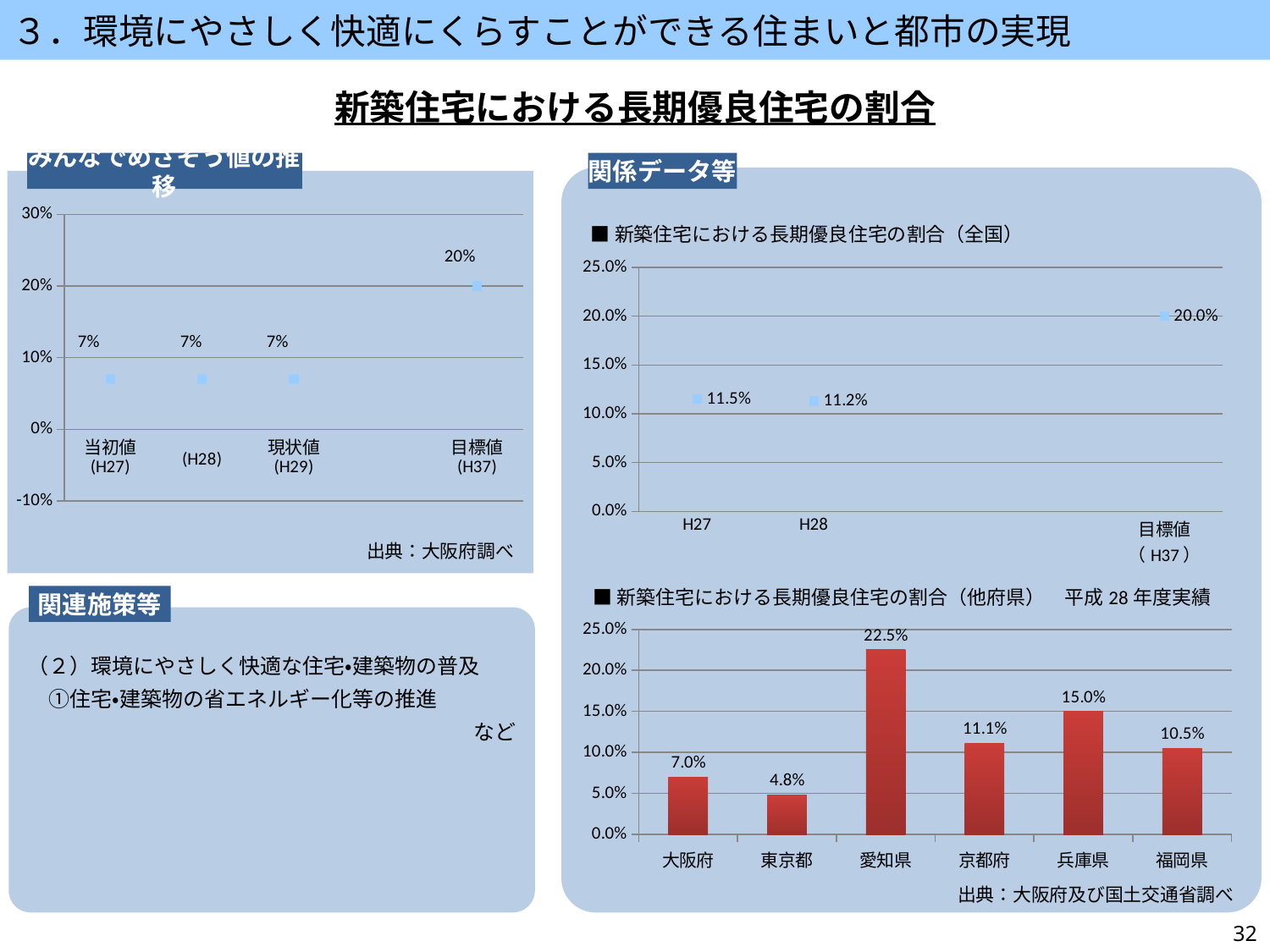
In the bottom-right bar chart (新築住宅における長期優良住宅の割合（他府県）), which prefecture has the lowest value? 東京都 In the bottom-right bar chart (新築住宅における長期優良住宅の割合（他府県）), which is larger, 京都府 or 福岡県? 京都府 In the left chart (みんなでめざそう値の推移), what is the value for 現状値（H29）? 7% In the bottom-right bar chart (新築住宅における長期優良住宅の割合（他府県）), what is the difference between 兵庫県 and 大阪府? 8.0% In the bottom-right bar chart (新築住宅における長期優良住宅の割合（他府県）), what is the value for 東京都? 4.8% How many prefectures are shown in the bottom-right bar chart (新築住宅における長期優良住宅の割合（他府県）)? 6 What kind of chart is the bottom-right chart (新築住宅における長期優良住宅の割合（他府県）)? bar chart In the left chart (みんなでめざそう値の推移), what is the value for 目標値（H37）? 20% In the top-right chart (新築住宅における長期優良住宅の割合（全国）), what is the value for H27? 11.5% In the bottom-right bar chart (新築住宅における長期優良住宅の割合（他府県）), which prefecture has the highest value? 愛知県 In the bottom-right bar chart (新築住宅における長期優良住宅の割合（他府県）), what is the value for 愛知県? 22.5% In the top-right chart (新築住宅における長期優良住宅の割合（全国）), what is the value for 目標値（H37）? 20.0%